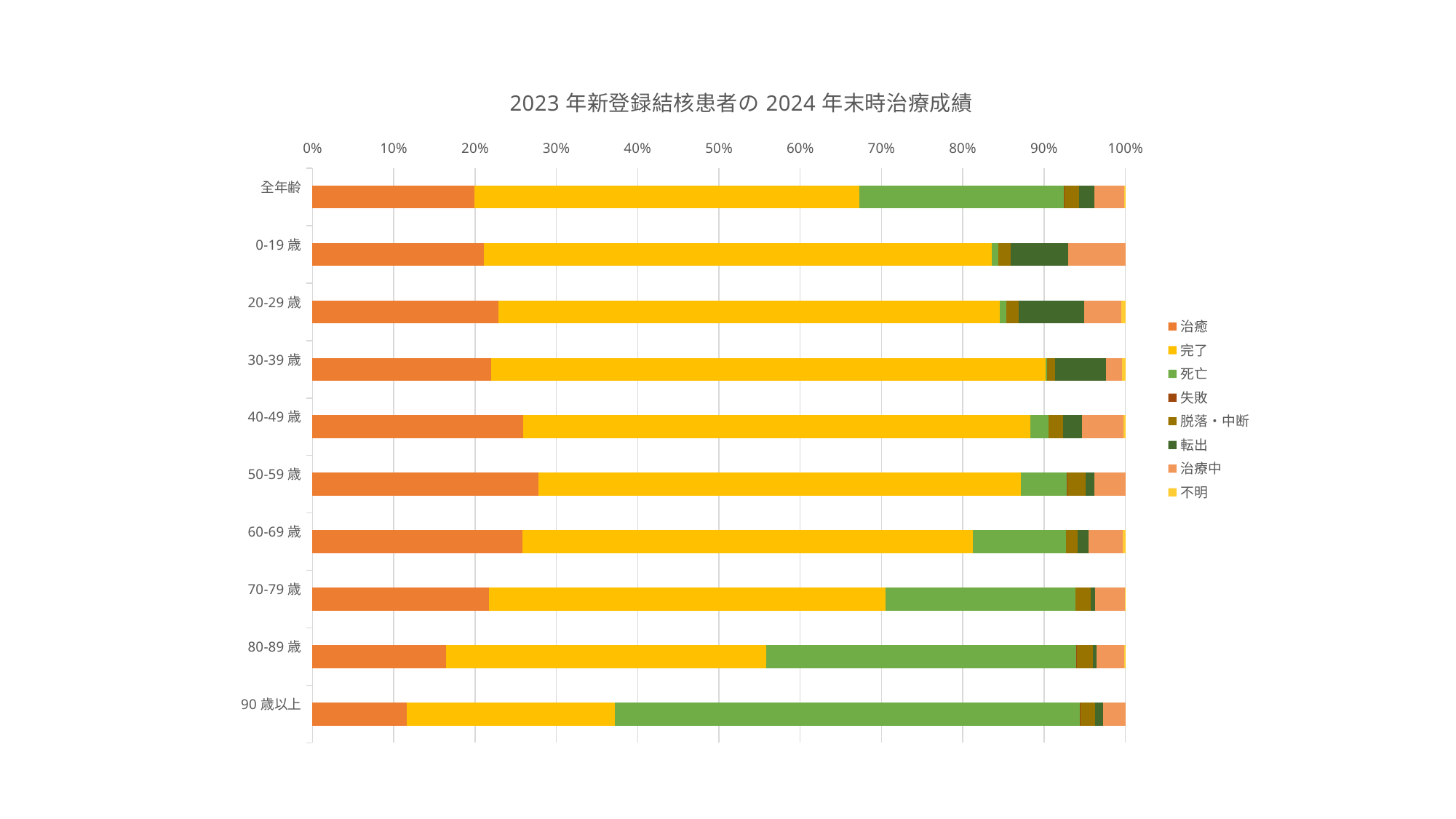
Which has the larger 完了 share, 30-39 歳 or 90 歳以上? 30-39 歳 Moving from 0-19 歳 down to 90 歳以上, does the 死亡 share generally rise or fall? rise How many series does the legend list? 8 Which age category has the largest 死亡 segment? 90 歳以上 Which has the larger 死亡 share, 70-79 歳 or 80-89 歳? 80-89 歳 Is the 治癒 share for 80-89 歳 greater or less than 20%? less What is the title of the chart? 2023 年新登録結核患者の 2024 年末時治療成績 Is the 死亡 share for 90 歳以上 greater or less than 50%? greater Which age category has the smallest 治癒 segment? 90 歳以上 Is the 治癒 share for 50-59 歳 greater or less than 20%? greater What kind of chart is shown on the slide? Stacked bar chart How many age categories are plotted on the vertical axis? 10